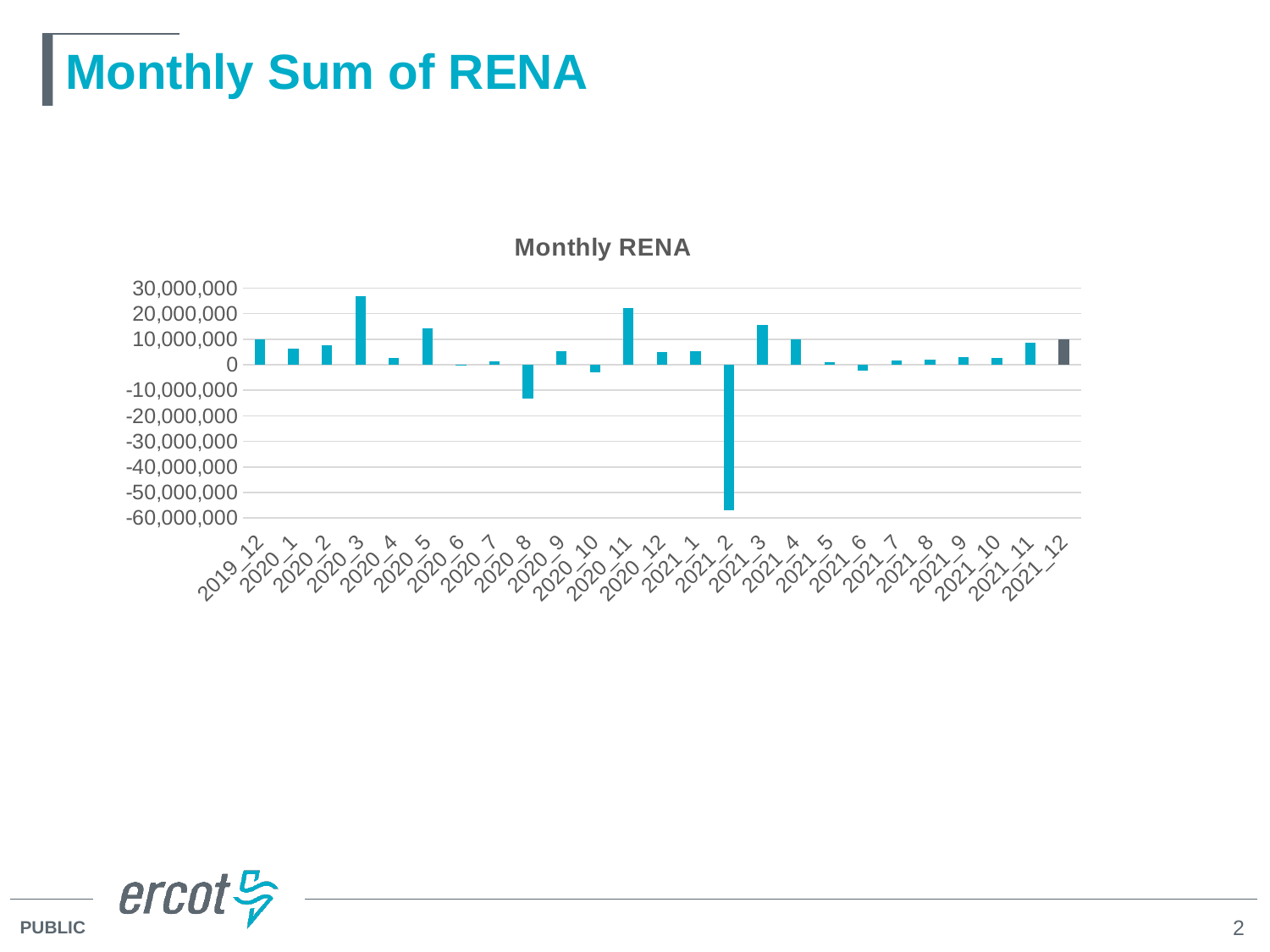
Is the value for 2020_8 greater or less than -10,000,000? less Which month's bar is shown in a different (dark grey) colour from the rest? 2021_12 Which month has the lowest Monthly RENA value? 2021_2 How many months (categories) are plotted on the x axis? 25 What kind of chart is shown on the slide? bar chart Is the value for 2021_2 greater or less than -50,000,000? less Is the value for 2021_3 greater or less than 10,000,000? greater Which is larger, the value for 2020_3 or the value for 2020_11? 2020_3 Which month has the highest Monthly RENA value? 2020_3 Which is lower, the value for 2020_8 or the value for 2021_2? 2021_2 What is the title of the chart? Monthly RENA